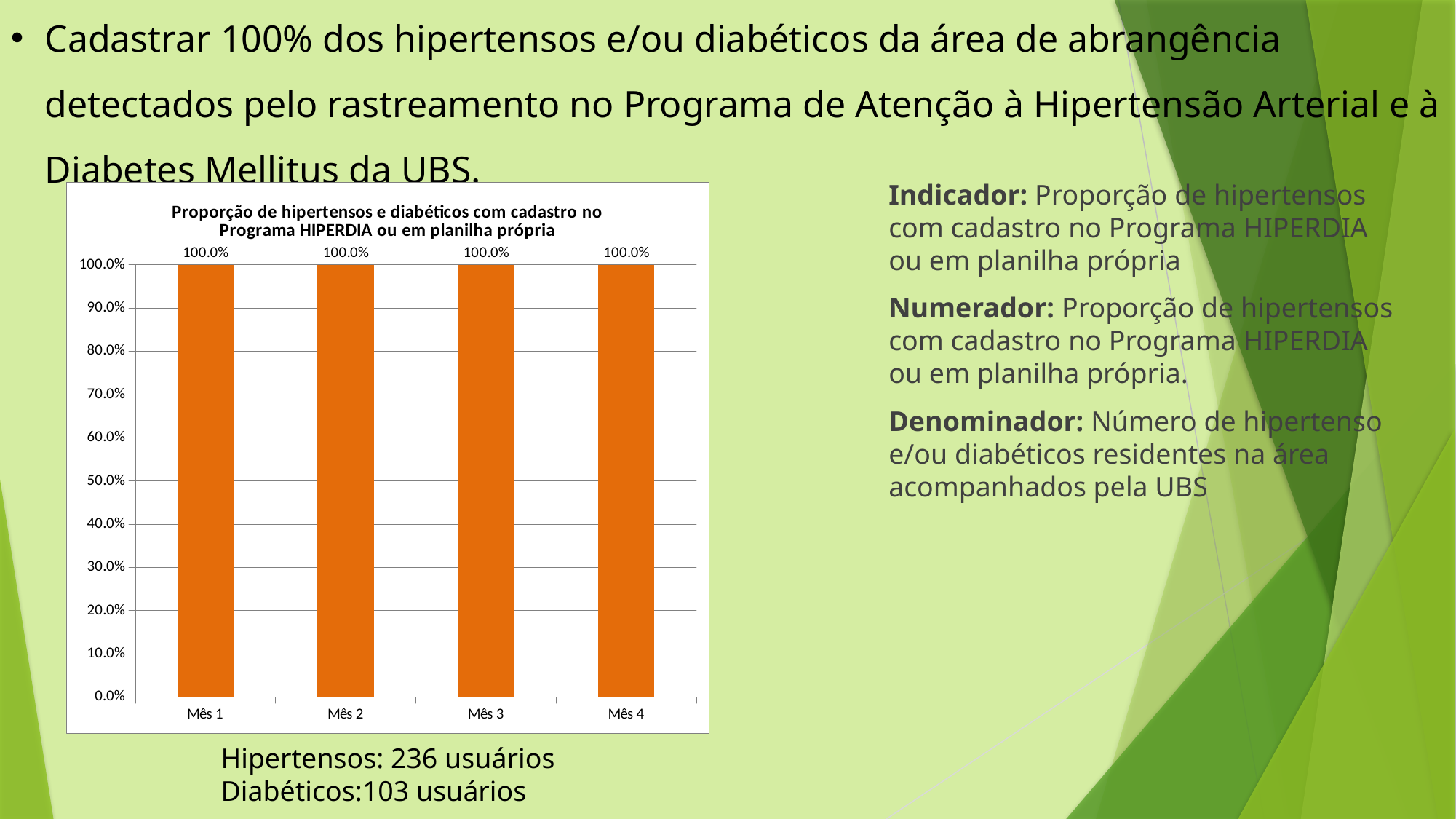
What kind of chart is shown on the slide? Bar chart What is the value for Mês 2 in the chart? 100.0% Do the values rise, fall or stay the same from Mês 1 to Mês 4? Stay the same What is the title of the chart? Proporção de hipertensos e diabéticos com cadastro no Programa HIPERDIA ou em planilha própria What colour are the bars in the chart? Orange What is the difference between the values for Mês 1 and Mês 4? 0.0% What is the value for Mês 1 in the chart? 100.0% Is the value for Mês 3 larger than, smaller than, or equal to the value for Mês 1? Equal Is the value for Mês 2 greater or less than 90.0%? greater How many categories (months) are shown on the x axis of the chart? 4 What is the value for Mês 3 in the chart? 100.0% What is the value for Mês 4 in the chart? 100.0%